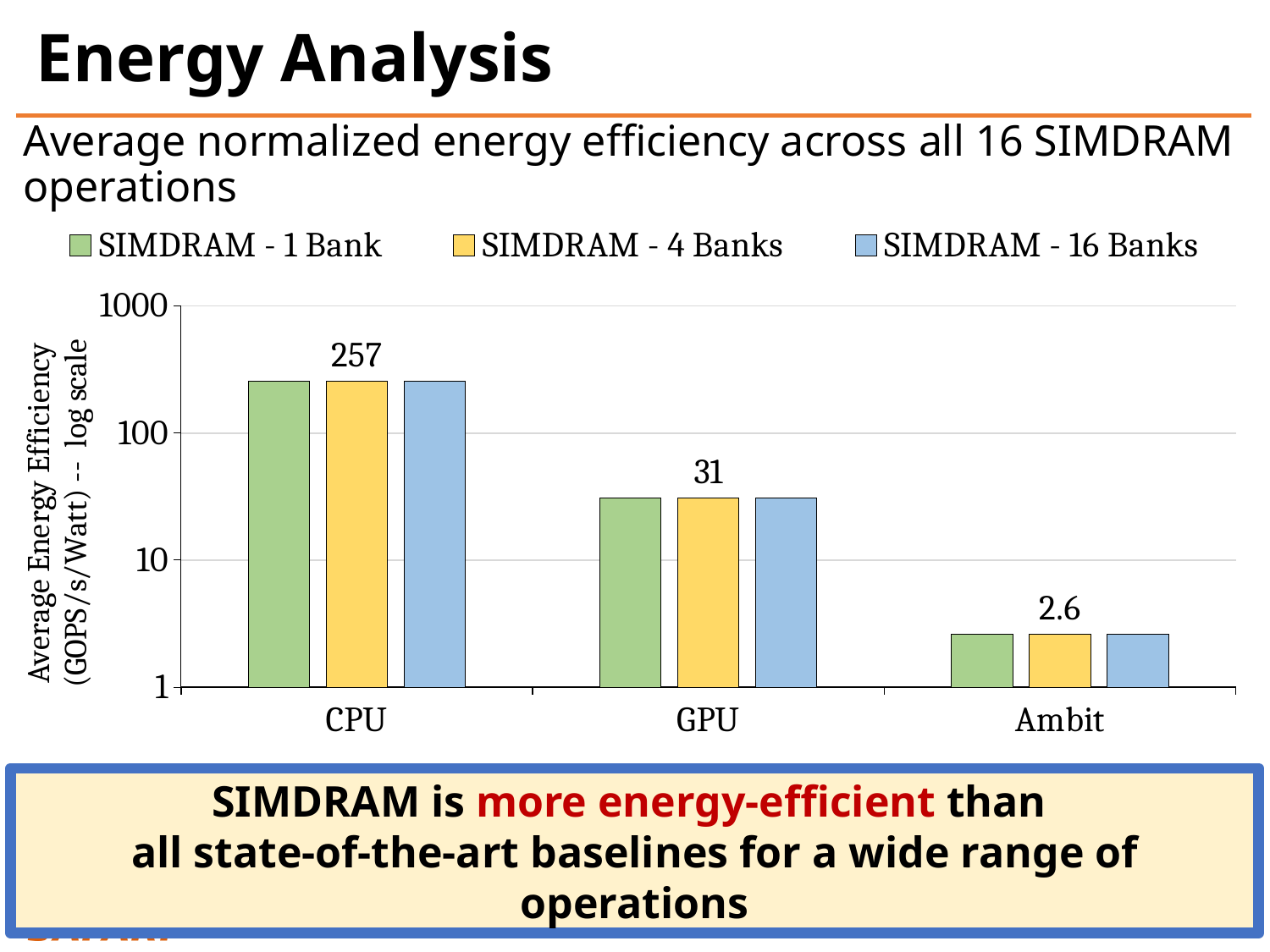
How many categories are shown on the x axis? 3 What is the labeled value for SIMDRAM - 4 Banks in the GPU category? 31 What kind of chart is shown on the slide? bar chart What is the labeled value for SIMDRAM - 4 Banks in the Ambit category? 2.6 How many series does the legend list? 3 What is the labeled value for SIMDRAM - 4 Banks in the CPU category? 257 Do the values rise or fall moving from CPU to Ambit along the x axis? fall Is the value for SIMDRAM - 1 Bank in the GPU category greater or less than 100? less Which category has the highest energy efficiency values? CPU What is the y-axis label of the chart? Average Energy Efficiency (GOPS/s/Watt) -- log scale Which category has the lowest energy efficiency values? Ambit Is the labeled value for CPU larger or smaller than the labeled value for GPU? larger